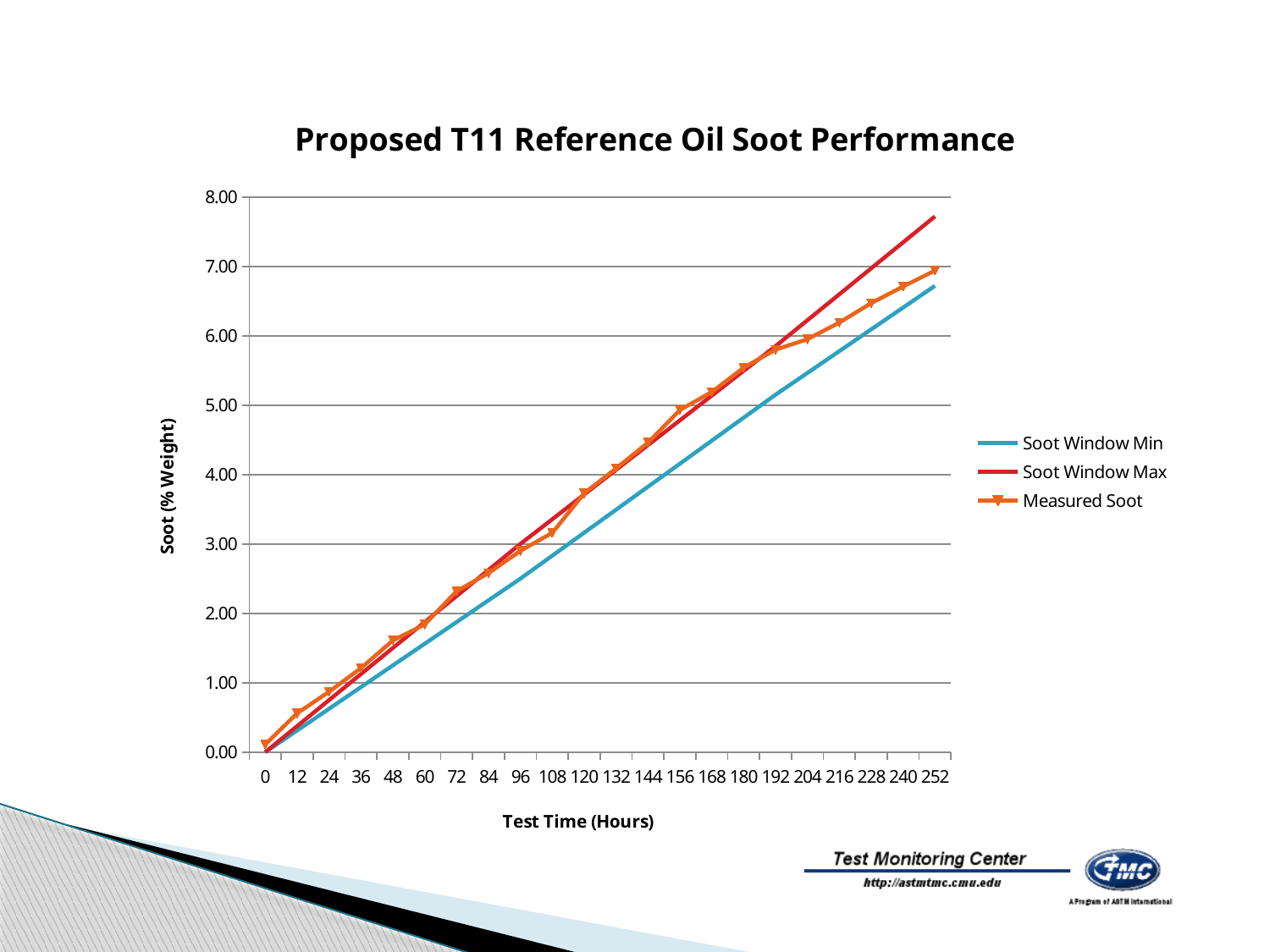
At 252 hours, which is higher: Measured Soot or Soot Window Min? Measured Soot How many test time points are marked along the x axis? 22 What is the label of the y axis? Soot (% Weight) What is the title of the chart? Proposed T11 Reference Oil Soot Performance Is the Soot Window Max value at 252 hours greater or less than 7.00? greater Does the Measured Soot series rise or fall as test time increases? rise How many series does the legend list? 3 What kind of chart is shown on the slide? line chart Is the Measured Soot value at 120 hours greater or less than 3.00? greater At 252 hours, which is higher: Soot Window Max or Measured Soot? Soot Window Max Is the Measured Soot value at 252 hours greater or less than 6.00? greater